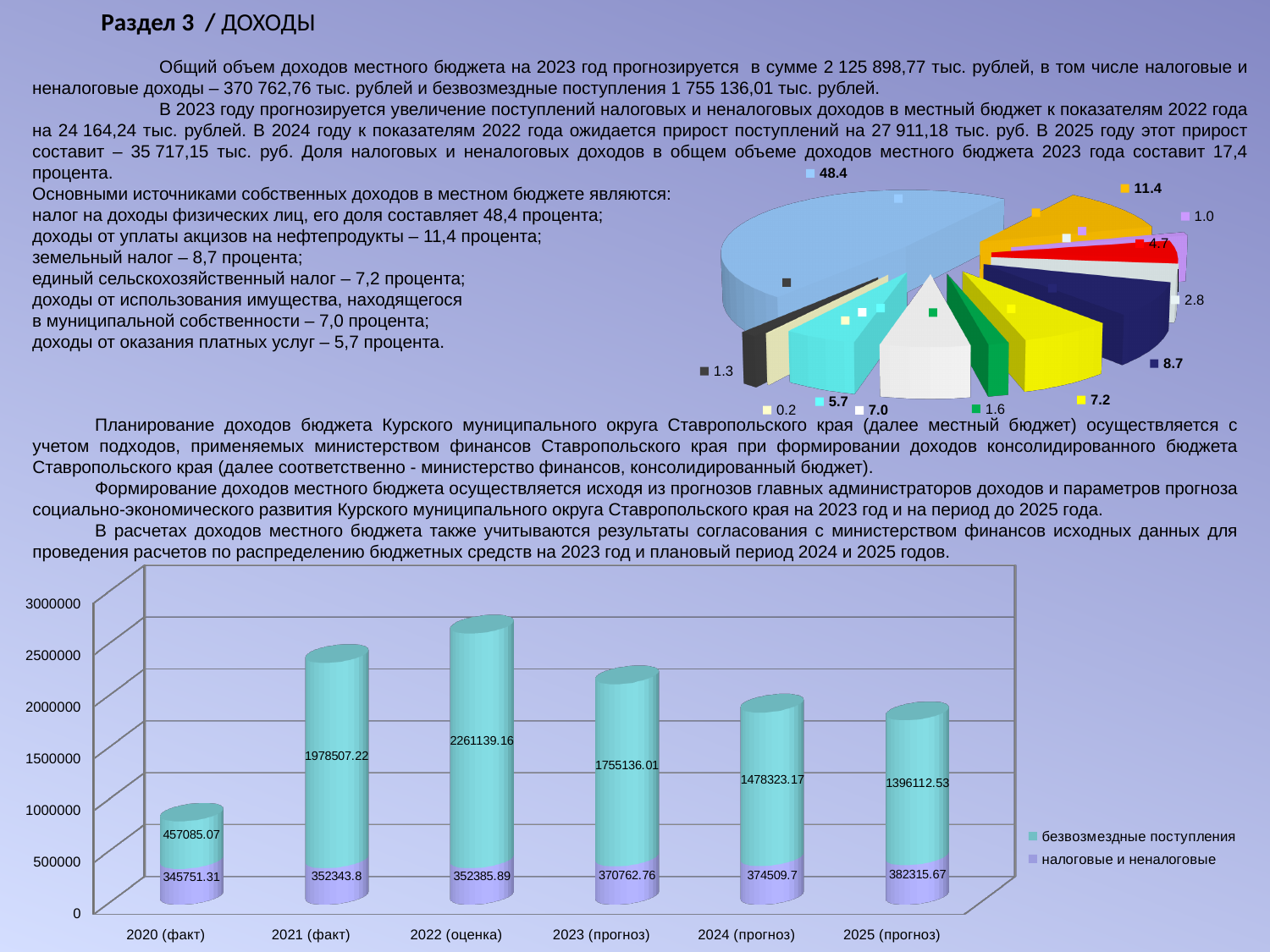
In the bar chart at the bottom of the slide, which is larger: налоговые и неналоговые in 2024 (прогноз) or in 2023 (прогноз)? 2024 (прогноз) In the bar chart at the bottom of the slide, which year has the lowest value of налоговые и неналоговые? 2020 (факт) In the bar chart at the bottom of the slide, what is the value of безвозмездные поступления for 2023 (прогноз)? 1755136.01 In the bar chart at the bottom of the slide, does the value of налоговые и неналоговые rise or fall from 2020 (факт) to 2025 (прогноз)? rise In the bar chart at the bottom of the slide, how many series does the legend list? 2 In the bar chart at the bottom of the slide, what is the value of налоговые и неналоговые for 2025 (прогноз)? 382315.67 In the bar chart at the bottom of the slide, which year has the highest value of безвозмездные поступления? 2022 (оценка) In the pie chart in the top right of the slide, what is the value of the largest slice? 48.4 What kind of chart is shown in the top right of the slide? pie chart In the bar chart at the bottom of the slide, what is the total of the stacked bar for 2023 (прогноз)? 2125898.77 In the bar chart at the bottom of the slide, how many years are shown on the x axis? 6 In the bar chart at the bottom of the slide, what is the difference between безвозмездные поступления in 2022 (оценка) and 2023 (прогноз)? 506003.15